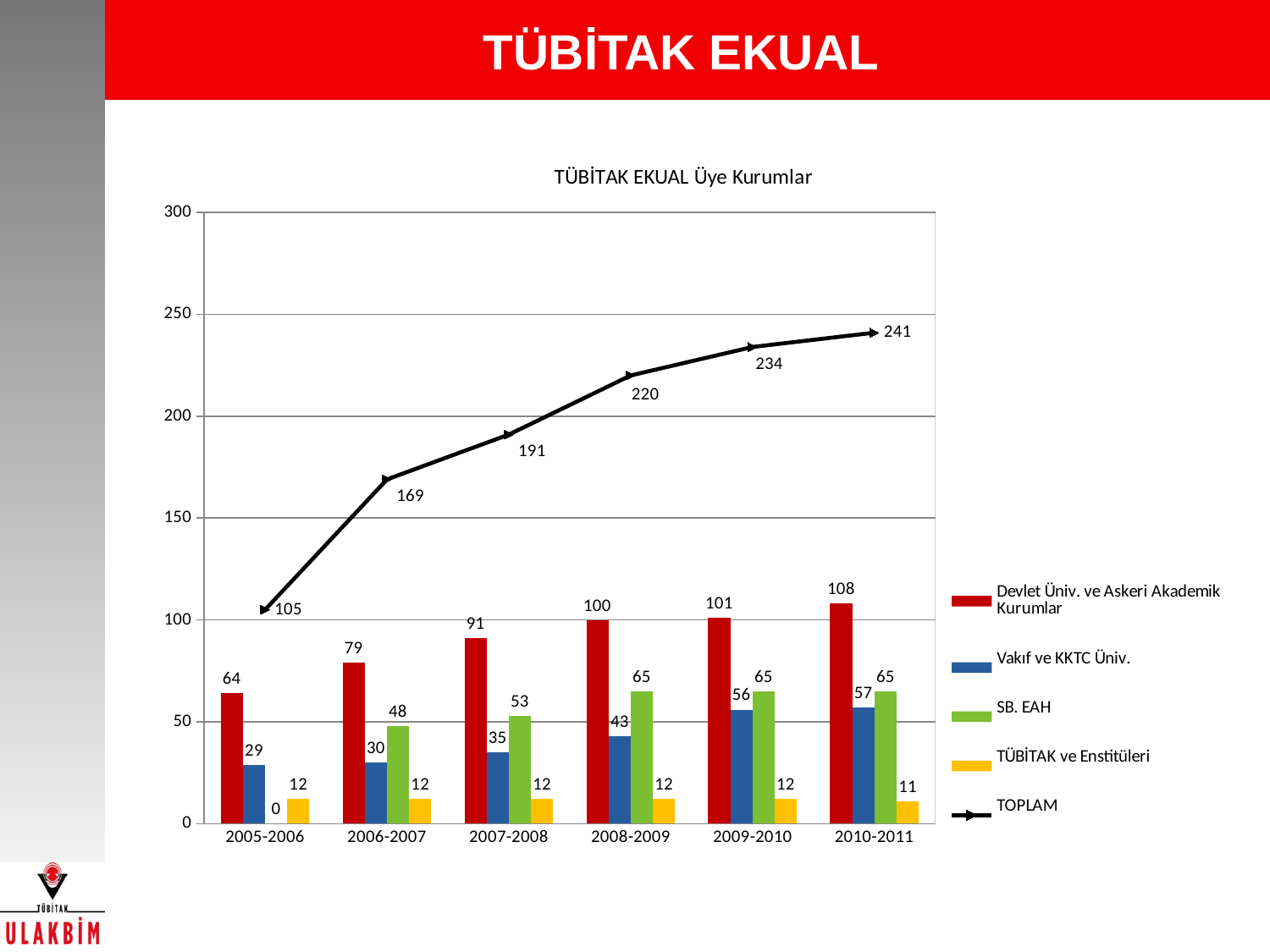
What is the TOPLAM value for 2010-2011? 241 How many periods are shown on the x axis? 6 What is the difference between the TOPLAM values for 2006-2007 and 2005-2006? 64 How many series does the legend list? 5 Which is larger in 2008-2009: the value for Vakıf ve KKTC Üniv. or the value for SB. EAH? SB. EAH What is the value for SB. EAH in 2005-2006? 0 What is the title of the chart? TÜBİTAK EKUAL Üye Kurumlar In which period is the value for Devlet Üniv. ve Askeri Akademik Kurumlar highest? 2010-2011 What is the value for Devlet Üniv. ve Askeri Akademik Kurumlar in 2007-2008? 91 In which period is the TOPLAM value lowest? 2005-2006 Does the TOPLAM line rise or fall from 2005-2006 to 2010-2011? rise What is the value for Vakıf ve KKTC Üniv. in 2009-2010? 56